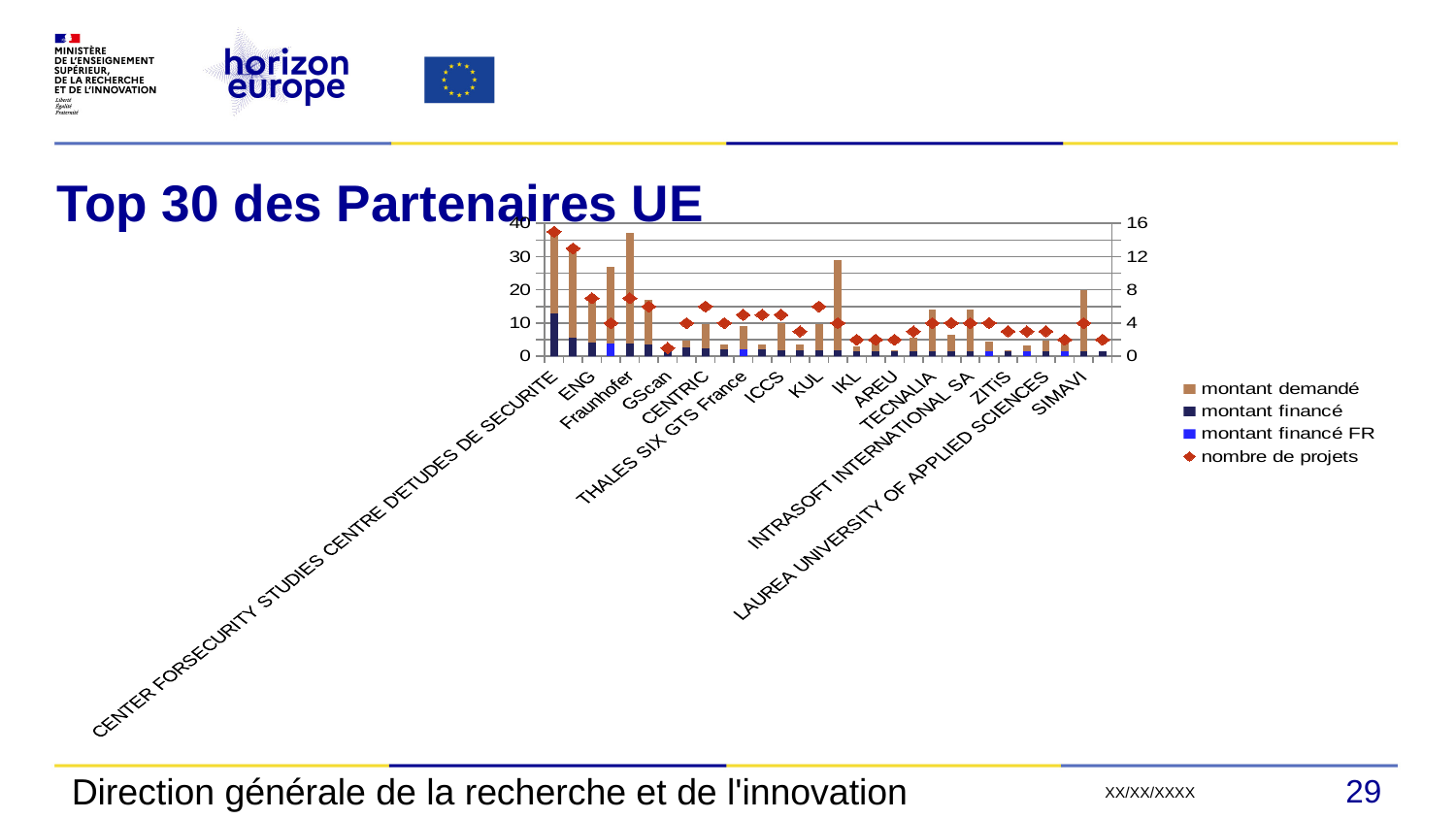
Which category has the highest value for nombre de projets? CENTER FOR SECURITY STUDIES CENTRE DETUDES DE SECURITE What is the maximum value shown on the left vertical axis? 40 Is the montant demandé for SIMAVI greater or less than 30? less Which is larger, the nombre de projets for CENTER FOR SECURITY STUDIES CENTRE DETUDES DE SECURITE or for SIMAVI? CENTER FOR SECURITY STUDIES CENTRE DETUDES DE SECURITE Which series is shown with red diamond markers? nombre de projets Is the montant demandé for CENTER FOR SECURITY STUDIES CENTRE DETUDES DE SECURITE greater or less than 30? greater Is the nombre de projets for CENTER FOR SECURITY STUDIES CENTRE DETUDES DE SECURITE greater or less than 12? greater What is the title of the slide's chart? Top 30 des Partenaires UE How many series does the legend list? 4 Which is larger, the montant demandé for CENTER FOR SECURITY STUDIES CENTRE DETUDES DE SECURITE or for GScan? CENTER FOR SECURITY STUDIES CENTRE DETUDES DE SECURITE What kind of chart is shown on the slide? Bar chart with a marker series (combo chart)